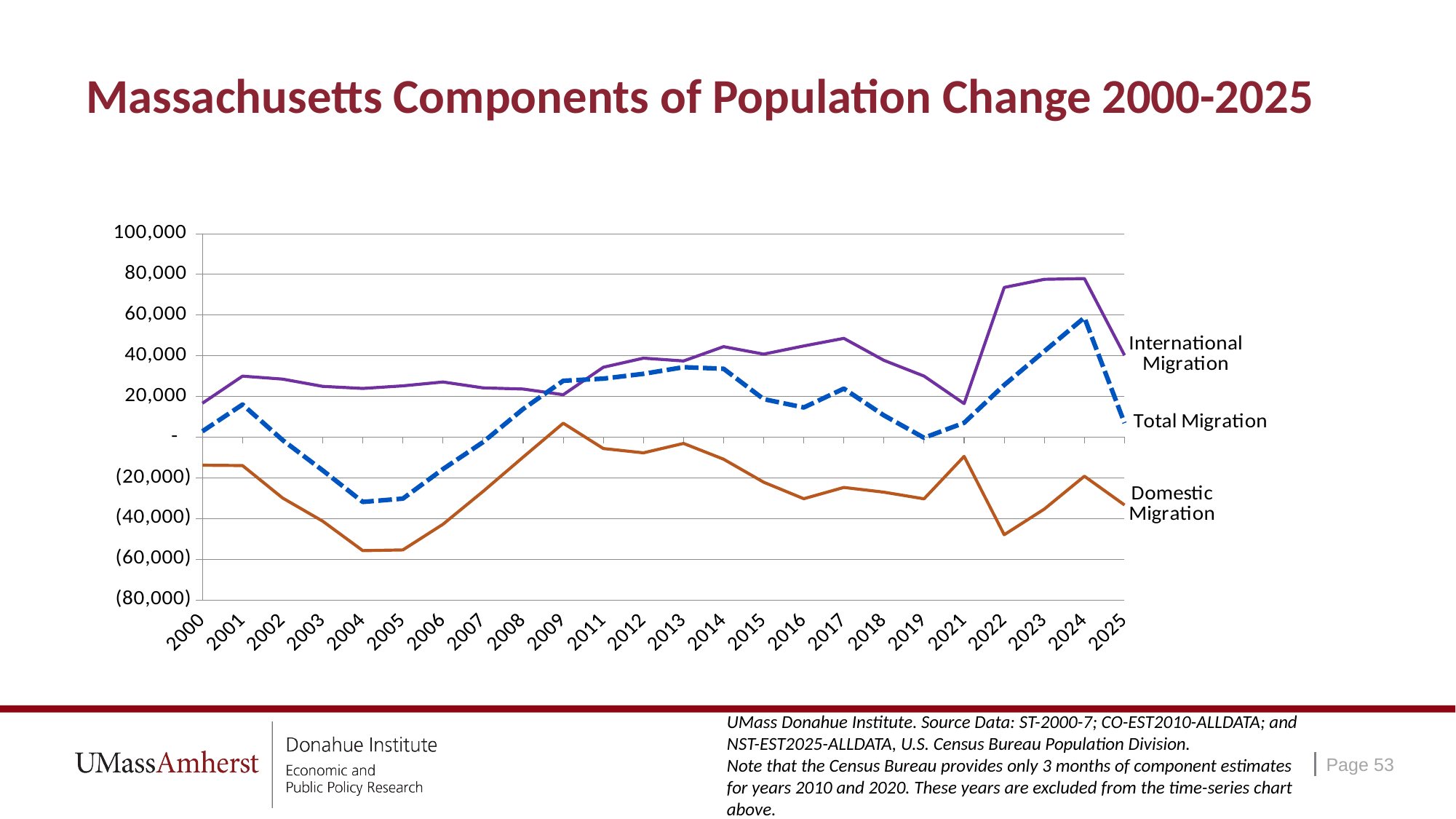
How many years are plotted along the x axis? 24 Does International Migration rise or fall from 2021 to 2024? Rise Is the value for Domestic Migration in 2022 greater or less than (40,000)? less Is the value for Total Migration in 2004 greater or less than (20,000)? less What kind of chart is shown on the slide? Line chart How many series are plotted on the chart? 3 What is the title of the chart? Massachusetts Components of Population Change 2000-2025 Which series is drawn with a dashed line? Total Migration Is the value for International Migration in 2022 greater or less than 60,000? greater In which year does Total Migration reach its highest value? 2024 In which year does Domestic Migration reach its highest value? 2009 Which is larger in 2013, International Migration or Domestic Migration? International Migration